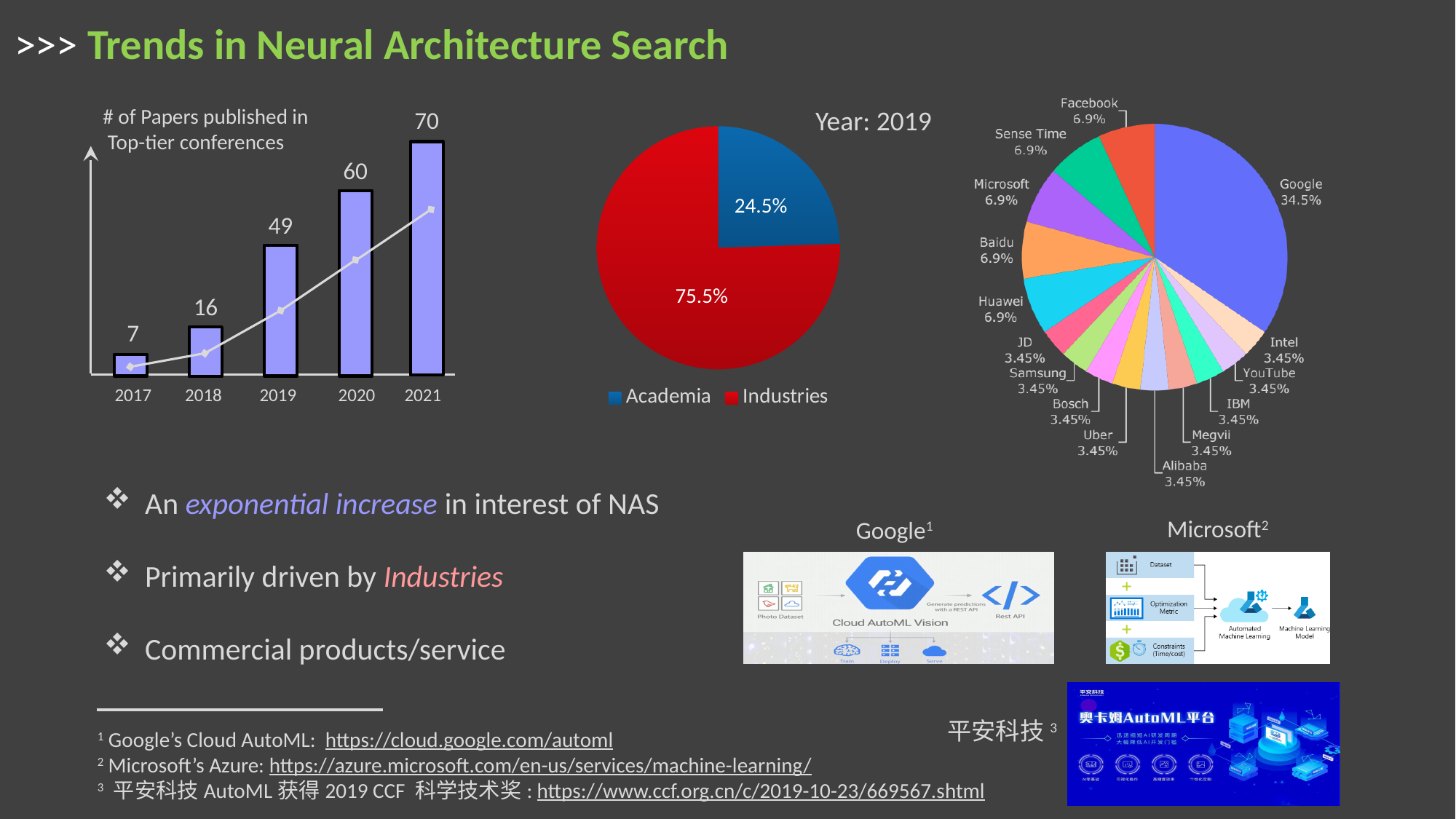
In the Year: 2019 pie chart, what share is Academia? 24.5% In the bar chart of papers published in top-tier conferences, how many papers were published in 2019? 49 In the bar chart of papers published in top-tier conferences, do the values rise or fall from 2017 to 2021? rise In the Year: 2019 pie chart, how many entries does the legend list? 2 In the company pie chart on the right, which company has the largest slice? Google In the company pie chart on the right, what is the difference between the Google and Microsoft shares? 27.6% In the bar chart of papers published in top-tier conferences, which year has the highest value? 2021 In the bar chart of papers published in top-tier conferences, what is the difference between the 2021 and 2020 values? 10 In the bar chart of papers published in top-tier conferences, how many years are shown on the x axis? 5 In the bar chart of papers published in top-tier conferences, which year has the lowest value? 2017 In the Year: 2019 pie chart, what share is Industries? 75.5% In the company pie chart on the right, what share is Google? 34.5%